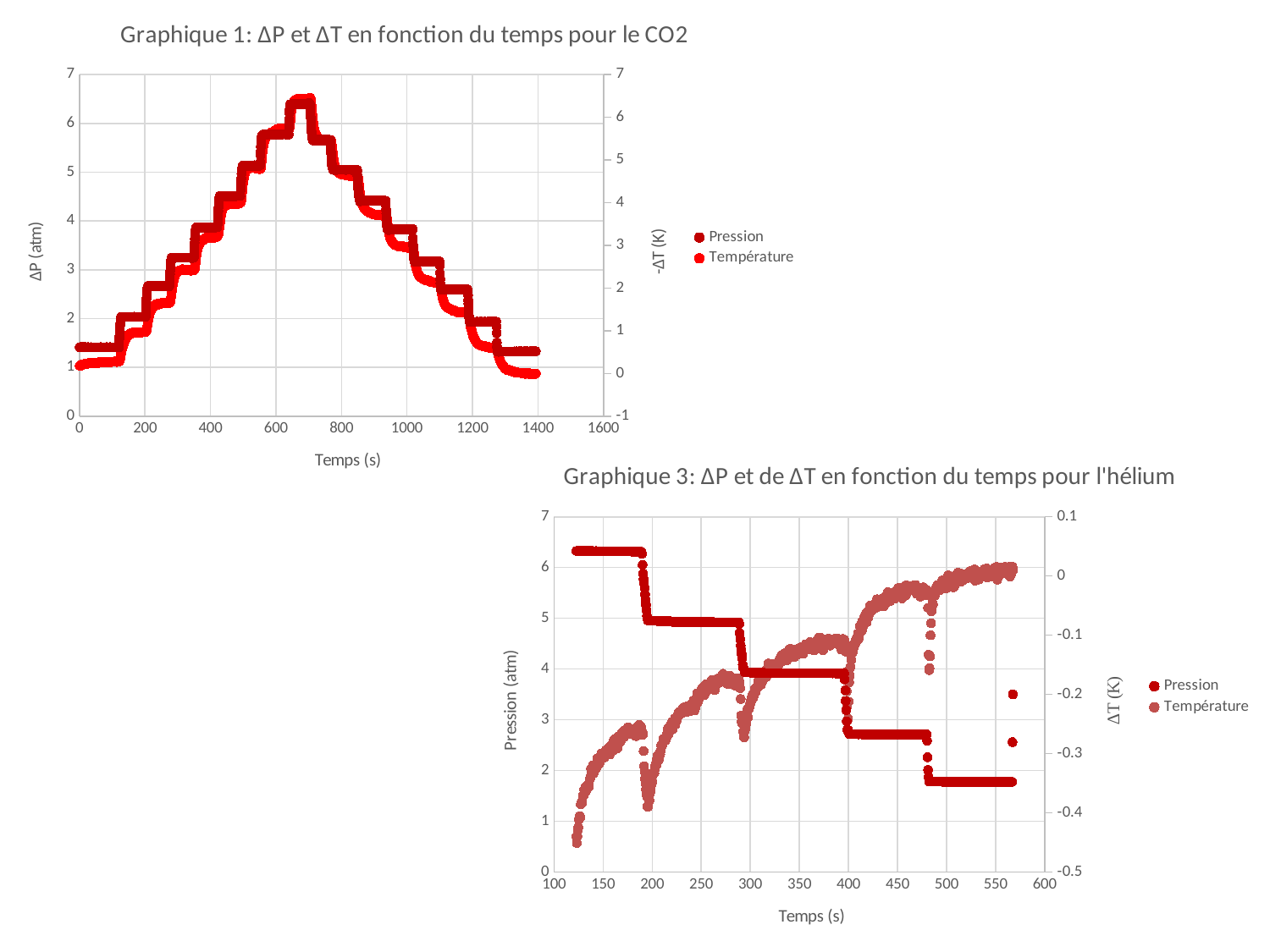
In Graphique 3, does the Pression series rise or fall as time increases? fall In Graphique 1, does the Pression series rise or fall between 800 s and 1400 s? fall What are the two series named in the legend of Graphique 3? Pression and Température What is the x-axis label of Graphique 3? Temps (s) In Graphique 1, does the Pression series rise or fall between 0 s and 600 s? rise What kind of chart is Graphique 1? scatter chart In Graphique 3, is the Pression value at 150 s greater or less than 6 atm? greater In Graphique 3, is the Pression value at 550 s greater or less than 2 atm? less In Graphique 1, is the Pression value at 0 s greater or less than 2 atm? less How many series does the legend of Graphique 1 list? 2